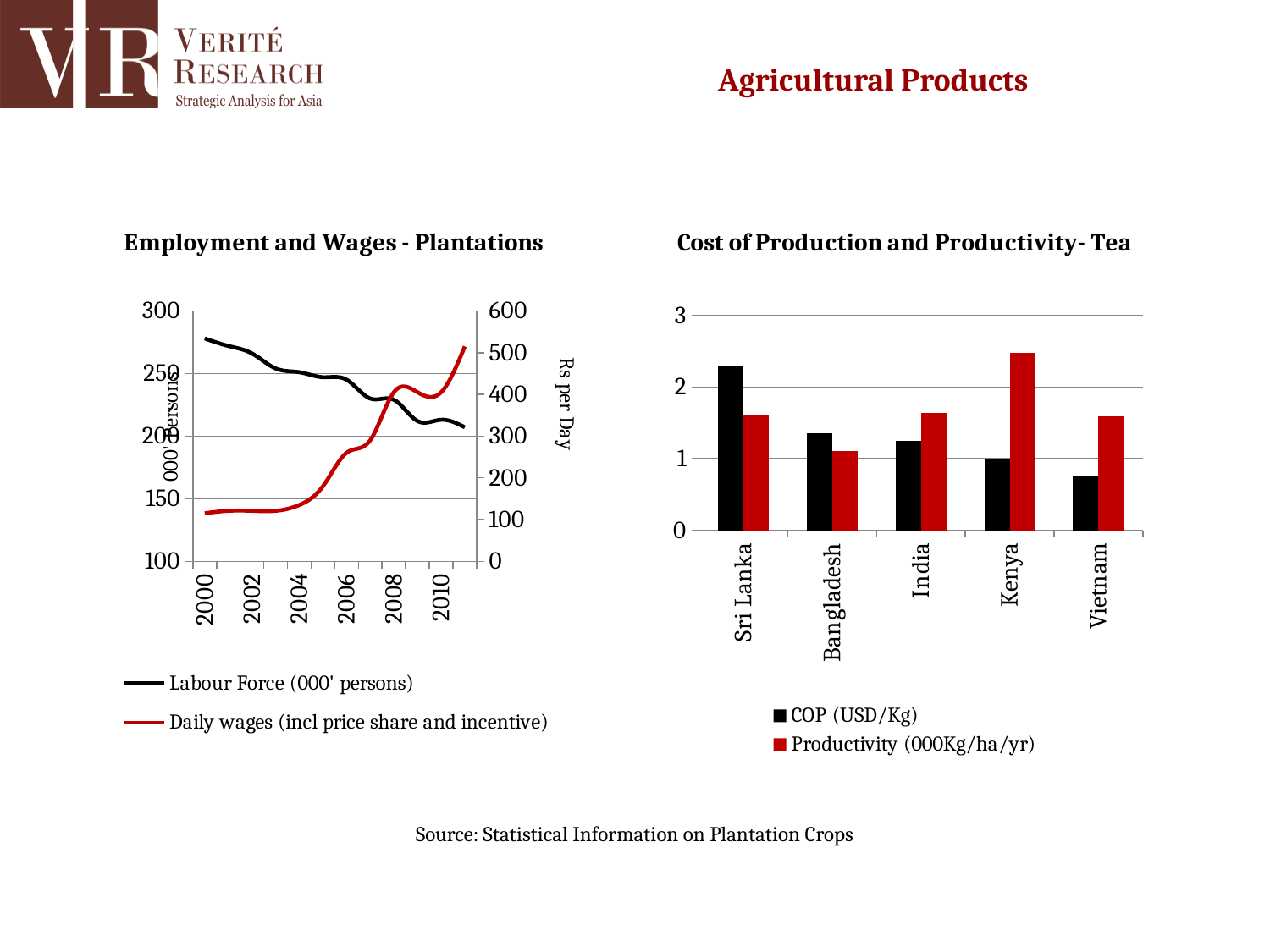
In the 'Cost of Production and Productivity- Tea' chart, how many countries are shown on the x axis? 5 How many series does the legend of the 'Employment and Wages - Plantations' chart list? 2 In the 'Cost of Production and Productivity- Tea' chart, which country has the highest COP (USD/Kg)? Sri Lanka In the 'Cost of Production and Productivity- Tea' chart, is the COP value for Vietnam greater or less than 1? less What kind of chart is the 'Cost of Production and Productivity- Tea' chart? bar chart In the 'Cost of Production and Productivity- Tea' chart, is the COP value for Sri Lanka greater or less than 2? greater In the 'Employment and Wages - Plantations' chart, does the Labour Force line rise or fall from 2000 to 2011? fall What kind of chart is the 'Employment and Wages - Plantations' chart? line chart In the 'Cost of Production and Productivity- Tea' chart, which country has the highest Productivity (000Kg/ha/yr)? Kenya In the 'Cost of Production and Productivity- Tea' chart, which country has the lowest COP (USD/Kg)? Vietnam In the 'Employment and Wages - Plantations' chart, does the Daily wages line rise or fall from 2000 to 2011? rise In the 'Cost of Production and Productivity- Tea' chart, which is larger for Kenya: COP or Productivity? Productivity